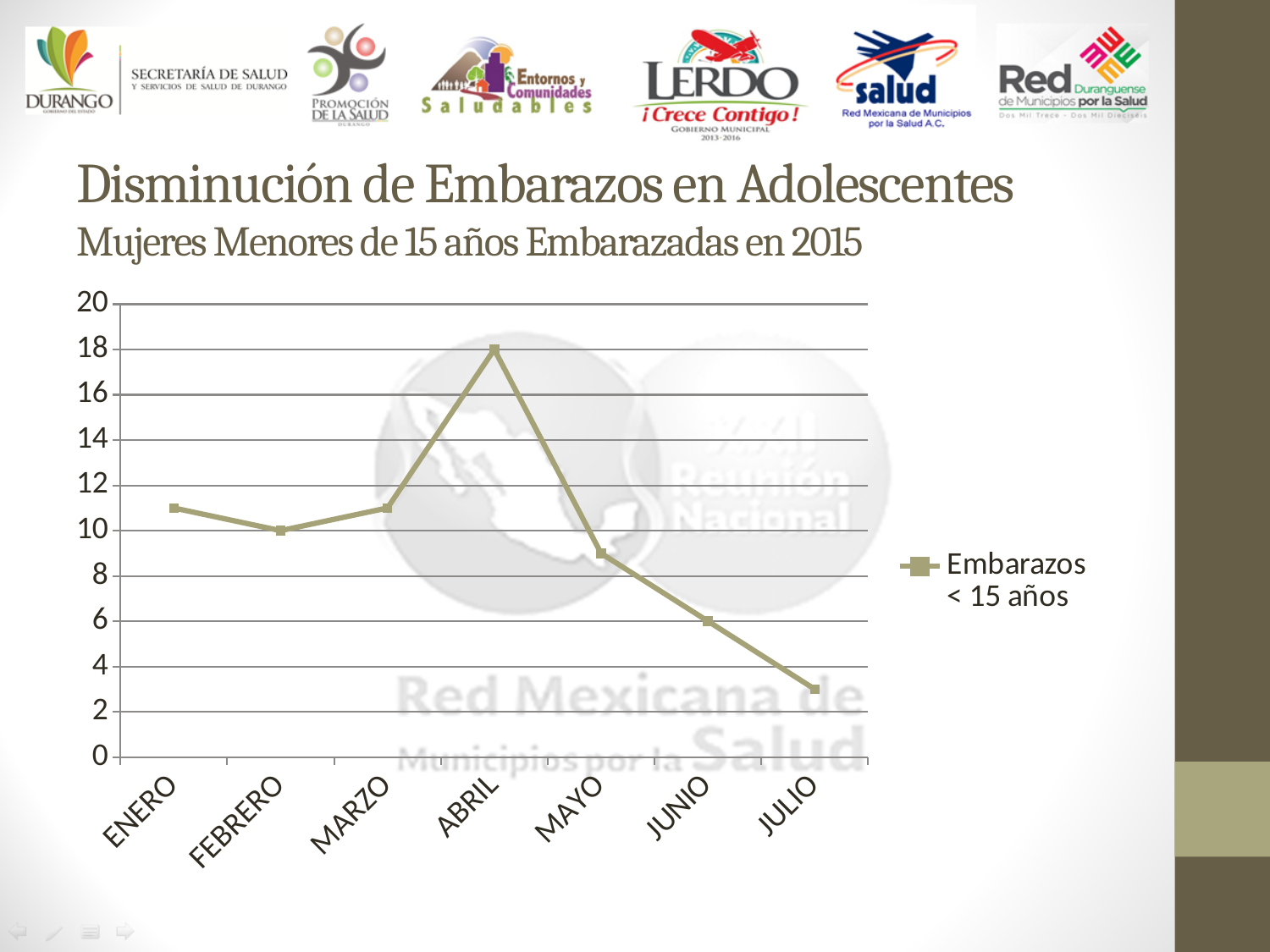
Which month has the lowest value? JULIO What is the difference between the values for ABRIL and FEBRERO? 8 What is the value for FEBRERO? 10 How many series does the legend list? 1 What is the value for ABRIL? 18 What kind of chart is shown on the slide? line chart How many months are plotted on the x axis? 7 What is the value for JUNIO? 6 What is the name of the series shown in the legend? Embarazos < 15 años Which month has the highest value? ABRIL Do the values rise or fall from ABRIL to JULIO? fall Is the value for JULIO greater or less than 4? less